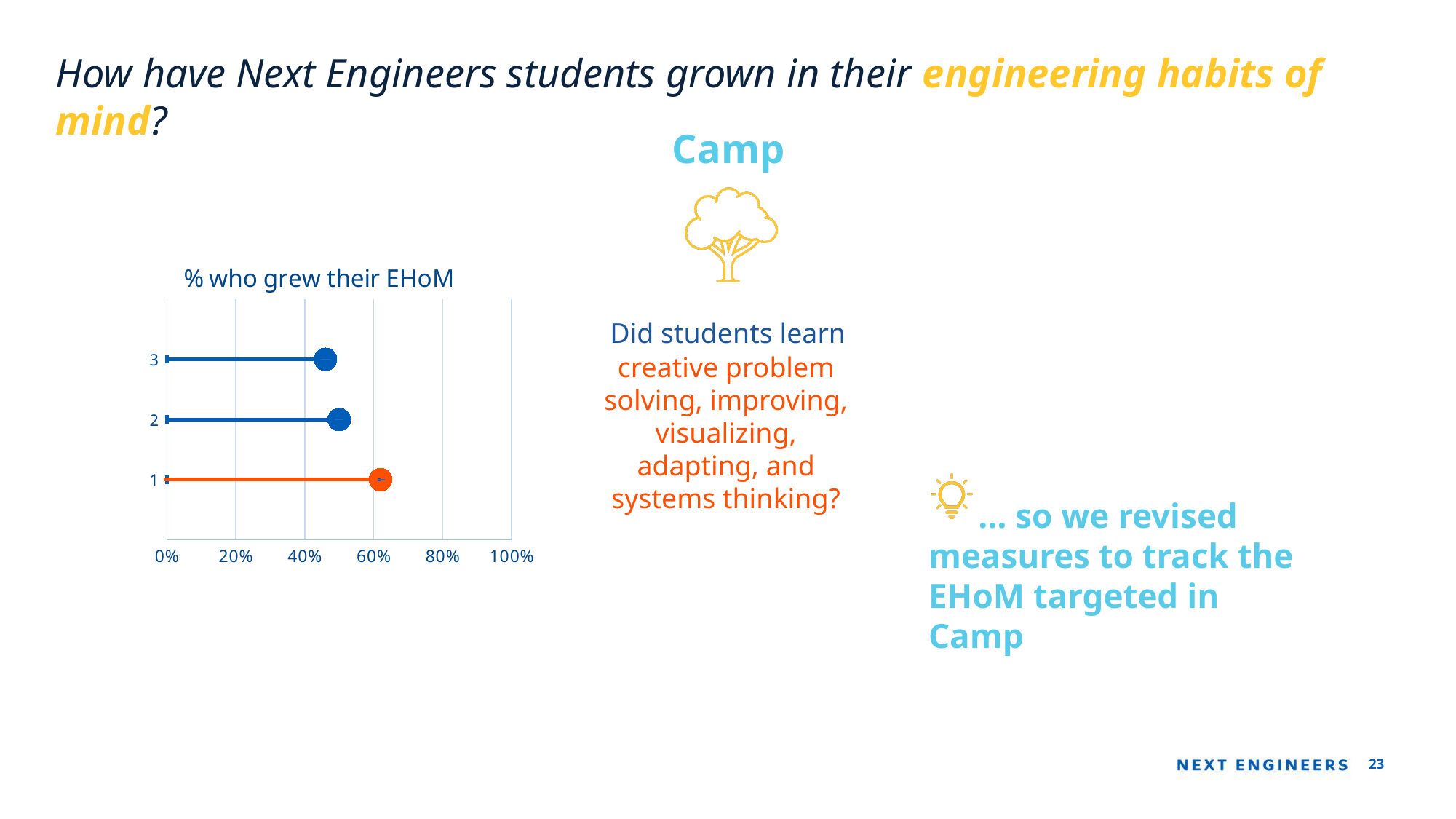
Is the value for category 3 greater or less than 20%? greater Which has a larger value, category 1 or category 3? 1 Is the value for category 1 greater or less than 40%? greater Is the value for category 2 greater or less than 80%? less How many categories are plotted in the chart? 3 Which category has the highest value in the chart? 1 Which has a larger value, category 1 or category 2? 1 What is the title of the chart on the slide? % who grew their EHoM What type of chart is shown on the slide? bar chart Which category's bar is drawn in orange rather than blue? 1